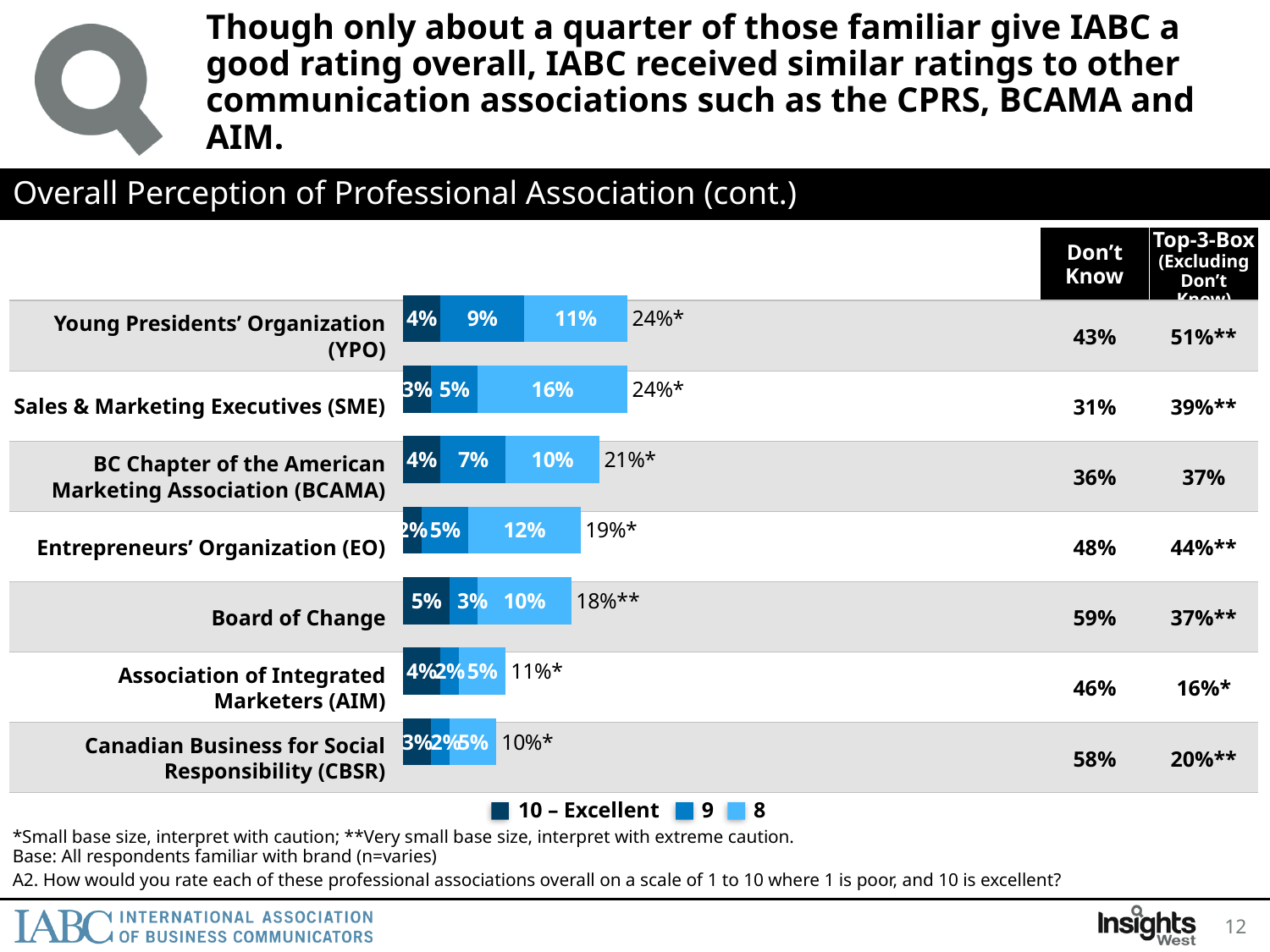
How many professional associations are shown in the chart? 7 What percentage of respondents gave Young Presidents' Organization (YPO) a rating of 9? 9% What is the difference between the '8' segment for SME (16%) and the '8' segment for YPO (11%)? 5% What percentage rated the BC Chapter of the American Marketing Association (BCAMA) as 10 – Excellent? 4% What is the total top-3 percentage shown at the end of the bar for Entrepreneurs' Organization (EO)? 19%* Which is larger: the '9' segment for YPO or the '9' segment for BCAMA? YPO Which association has the lowest total percentage shown at the end of its bar? Canadian Business for Social Responsibility (CBSR) Which association has the largest '8' segment? Sales & Marketing Executives (SME) How many series does the legend list? 3 Which association has the largest '10 – Excellent' segment? Board of Change What type of chart is used on this slide? Stacked bar chart What percentage of respondents rated Sales & Marketing Executives (SME) an 8? 16%